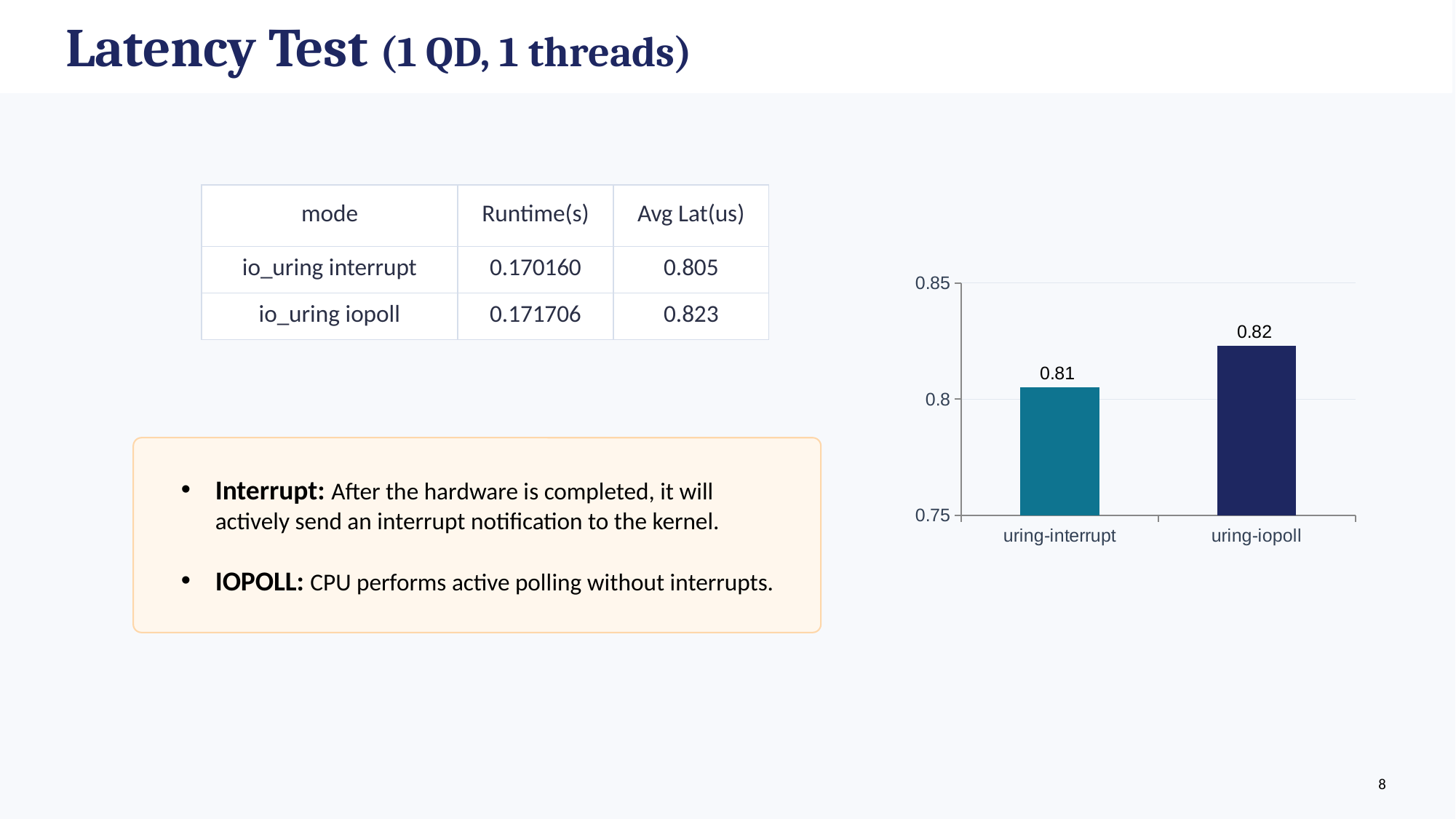
How many bars are plotted in the chart? 2 What is the lowest value shown on the chart's vertical axis? 0.75 What is the difference between the labelled values for uring-iopoll and uring-interrupt? 0.01 Is the value for uring-iopoll greater or less than 0.8? greater Do the bar values rise or fall from left to right along the x axis? rise What is the value shown for uring-iopoll in the bar chart? 0.82 Which is larger, the value for uring-interrupt or the value for uring-iopoll? uring-iopoll Which category has the lowest value in the bar chart? uring-interrupt What kind of chart is shown on the slide? bar chart Is the value for uring-interrupt greater or less than 0.85? less What is the value shown for uring-interrupt in the bar chart? 0.81 Which category has the highest value in the bar chart? uring-iopoll